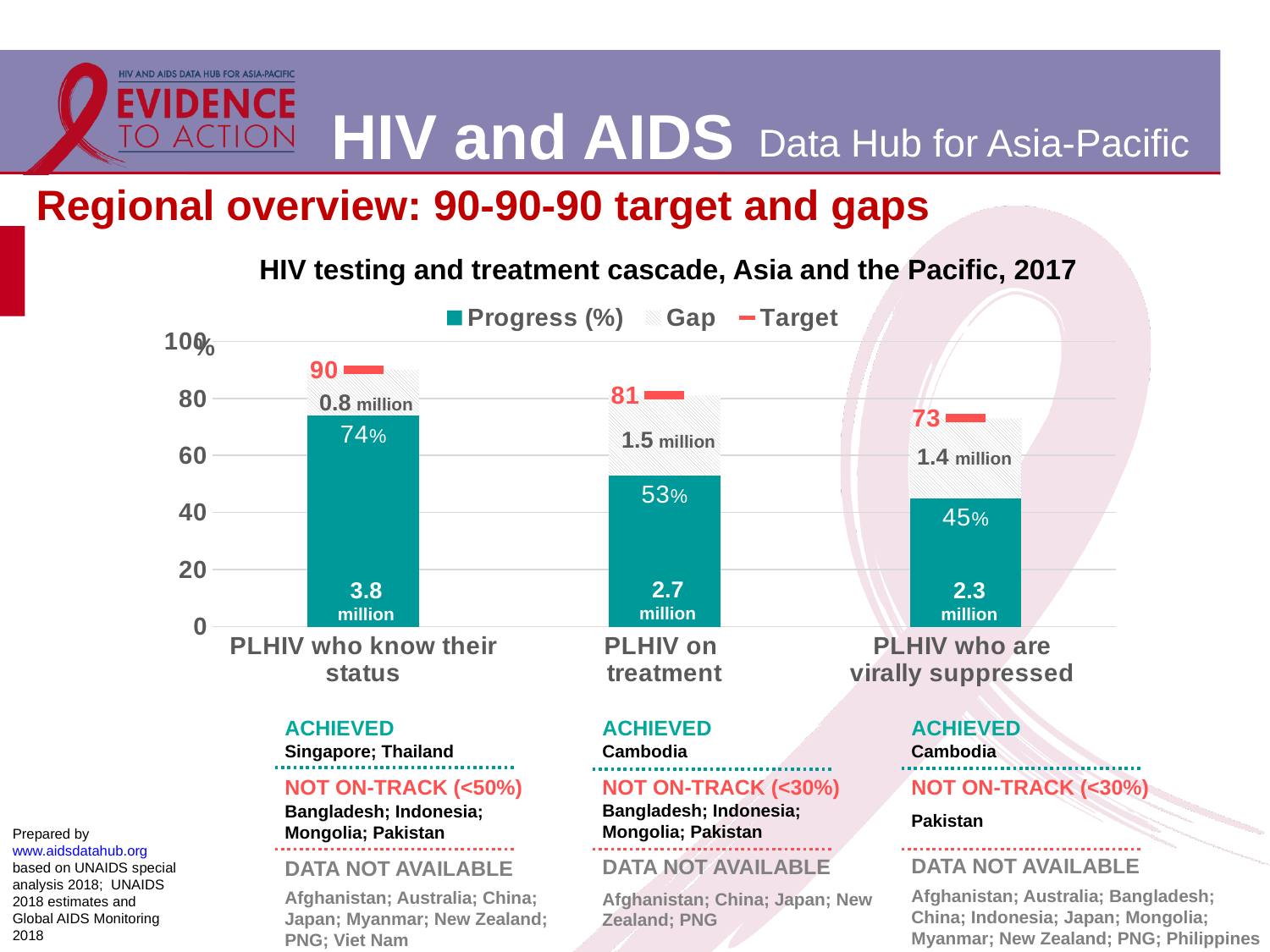
Which category has the highest progress percentage? PLHIV who know their status What is the gap shown for PLHIV who are virally suppressed? 1.4 million Do the progress percentages rise or fall from left to right across the three categories? Fall What type of chart is shown on the slide? Stacked bar chart What is the progress percentage for PLHIV who are virally suppressed? 45% What is the progress percentage for PLHIV who know their status? 74% What is the progress percentage for PLHIV on treatment? 53% What is the target value shown for PLHIV on treatment? 81 How many series does the legend list? 3 What is the difference in progress percentage between PLHIV who know their status and PLHIV on treatment? 21 percentage points Which category has the lowest progress percentage? PLHIV who are virally suppressed How many PLHIV know their status, according to the label on the bar? 3.8 million